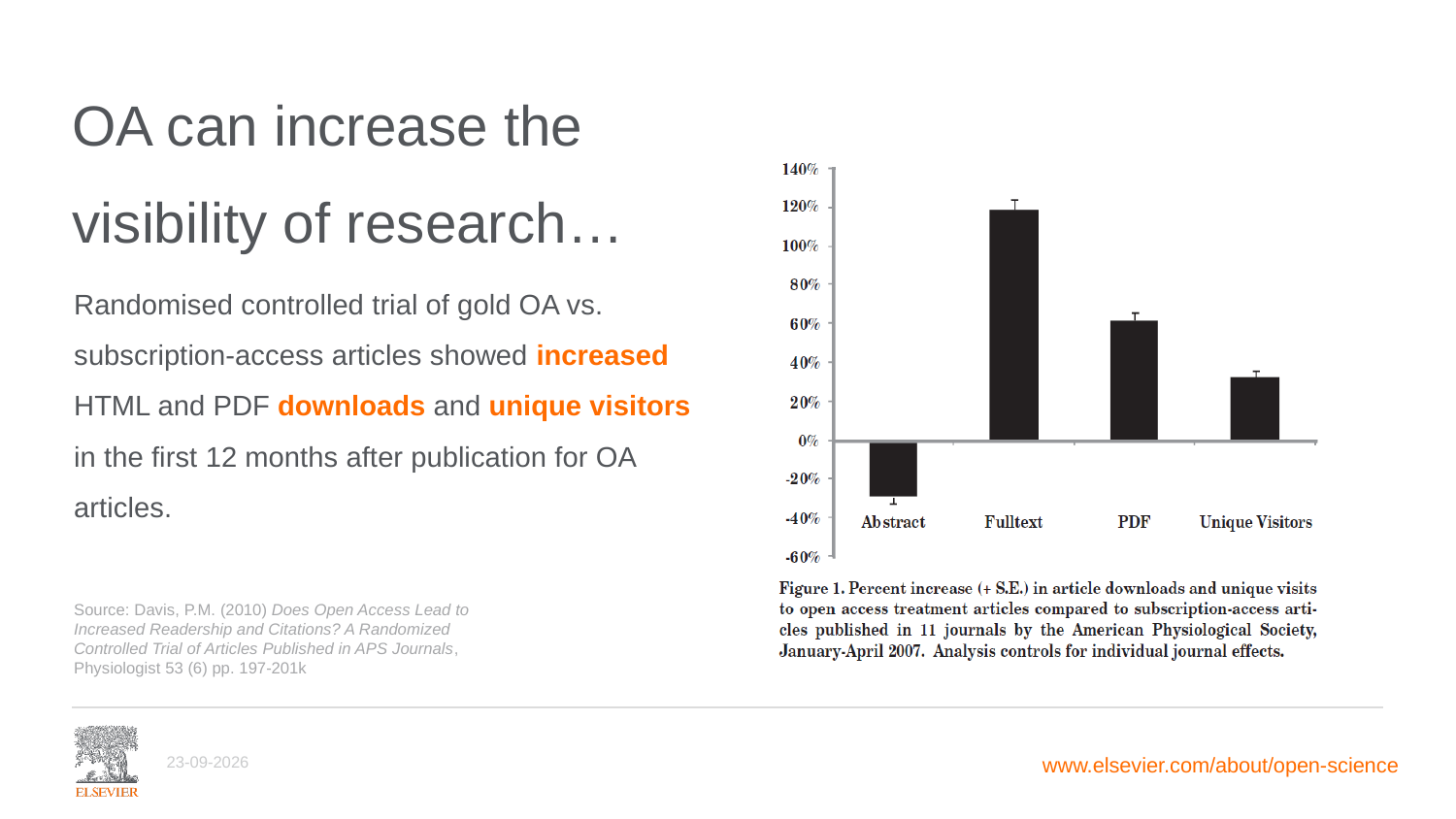
Which category is the only one with a negative value in the chart? Abstract Is the value for PDF greater or less than 40%? greater Is the value for Abstract greater or less than 0%? less Is the value for Fulltext greater or less than 100%? greater How many categories are shown on the x axis of the chart? 4 What kind of chart is shown on the slide? bar chart Which is larger, the value for PDF or the value for Unique Visitors? PDF What are the four category labels on the x axis of the chart, from left to right? Abstract, Fulltext, PDF, Unique Visitors Which is larger, the value for Fulltext or the value for PDF? Fulltext Which category has the lowest value in the chart? Abstract Which category has the highest percent increase in the chart? Fulltext